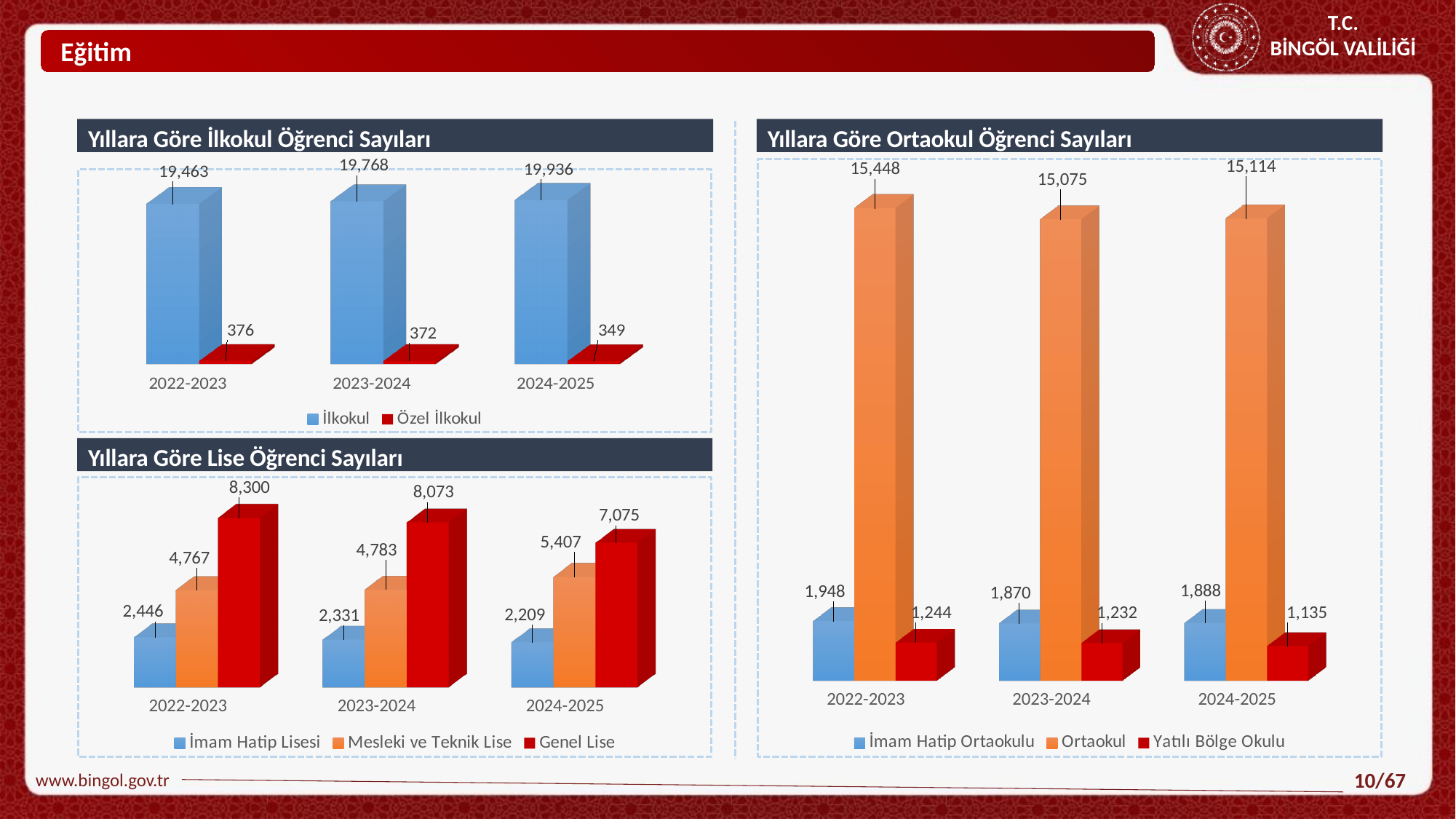
In the 'Yıllara Göre Ortaokul Öğrenci Sayıları' chart, what is the Ortaokul value for 2023-2024? 15,075 In the 'Yıllara Göre Ortaokul Öğrenci Sayıları' chart, which year has the highest Ortaokul value? 2022-2023 In the 'Yıllara Göre Lise Öğrenci Sayıları' chart, what is the Mesleki ve Teknik Lise value for 2024-2025? 5,407 In the 'Yıllara Göre İlkokul Öğrenci Sayıları' chart, does the Özel İlkokul series rise or fall from 2022-2023 to 2024-2025? fall In the 'Yıllara Göre Lise Öğrenci Sayıları' chart, how many series does the legend list? 3 In the 'Yıllara Göre Lise Öğrenci Sayıları' chart, what is the Genel Lise value for 2022-2023? 8,300 In the 'Yıllara Göre İlkokul Öğrenci Sayıları' chart, what is the Özel İlkokul value for 2022-2023? 376 In the 'Yıllara Göre İlkokul Öğrenci Sayıları' chart, what is the İlkokul value for 2024-2025? 19,936 What kind of chart is 'Yıllara Göre Ortaokul Öğrenci Sayıları'? bar chart In the 'Yıllara Göre Lise Öğrenci Sayıları' chart, which year has the lowest İmam Hatip Lisesi value? 2024-2025 In the 'Yıllara Göre İlkokul Öğrenci Sayıları' chart, what is the difference between the İlkokul values for 2023-2024 and 2022-2023? 305 In the 'Yıllara Göre Ortaokul Öğrenci Sayıları' chart, which is larger for 2024-2025: İmam Hatip Ortaokulu or Yatılı Bölge Okulu? İmam Hatip Ortaokulu